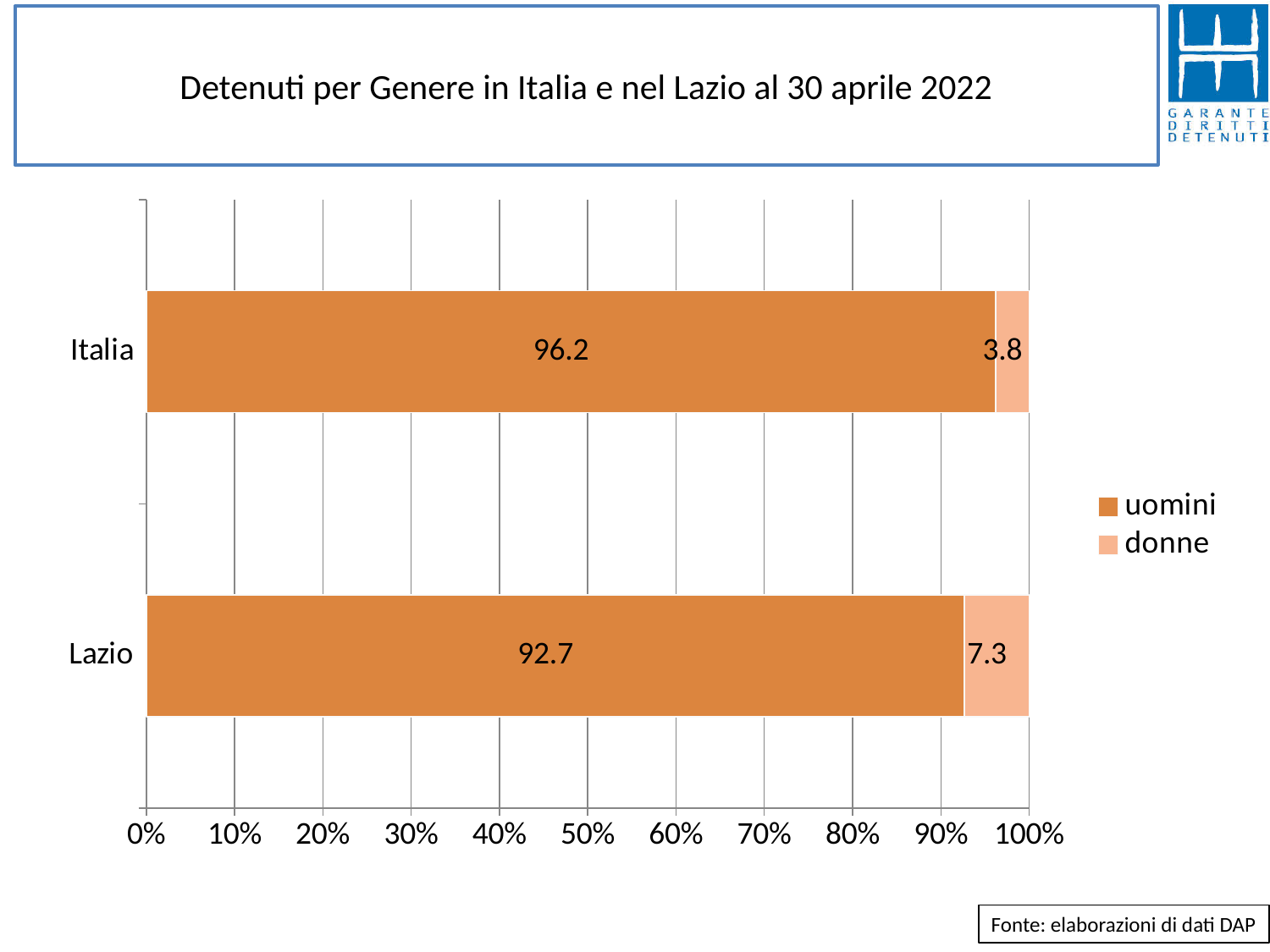
Which category has the lower value for uomini? Lazio Which category has the higher value for donne, Italia or Lazio? Lazio What kind of chart is shown on the slide? Stacked bar chart How many categories are shown on the chart? 2 What is the difference between the uomini values for Italia and Lazio? 3.5 What is the value for uomini in Lazio? 92.7 What is the title of the chart? Detenuti per Genere in Italia e nel Lazio al 30 aprile 2022 What is the value for uomini in Italia? 96.2 What is the difference between the donne values for Lazio and Italia? 3.5 What is the value for donne in Italia? 3.8 How many series does the legend list? 2 What is the value for donne in Lazio? 7.3